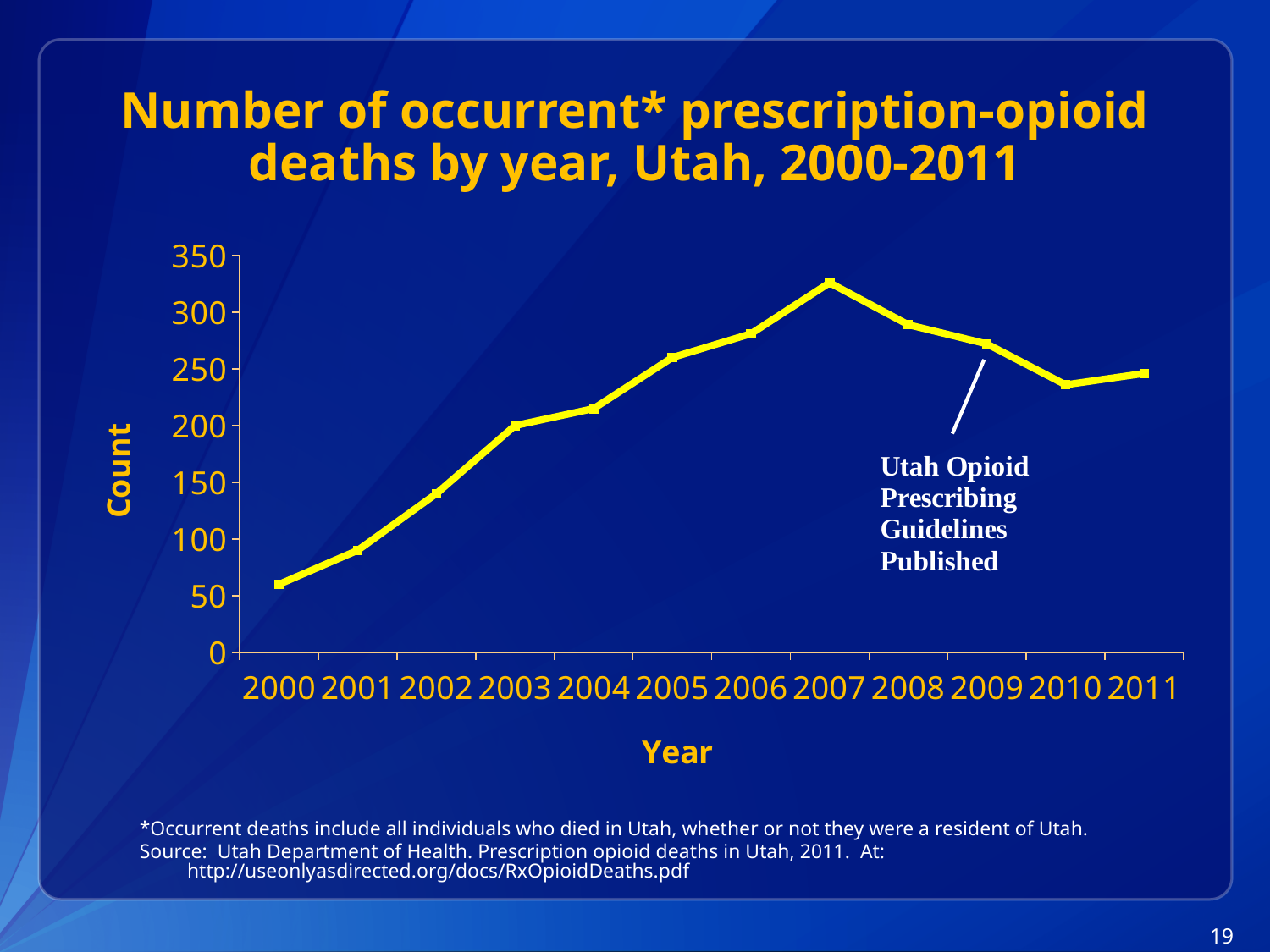
Is the value for 2007 greater or less than 300? greater What event does the annotation on the chart point to near 2009? Utah Opioid Prescribing Guidelines Published Do the values rise or fall from 2000 to 2007? Rise How many years (data points) are plotted on the chart? 12 Is the value for 2000 greater or less than 100? less What kind of chart is shown on the slide? Line chart Which year has more deaths, 2007 or 2011? 2007 Which year has the lowest number of occurrent prescription-opioid deaths? 2000 Which year has the highest number of occurrent prescription-opioid deaths? 2007 Is the value for 2006 greater or less than 250? greater What is the label on the y-axis of the chart? Count